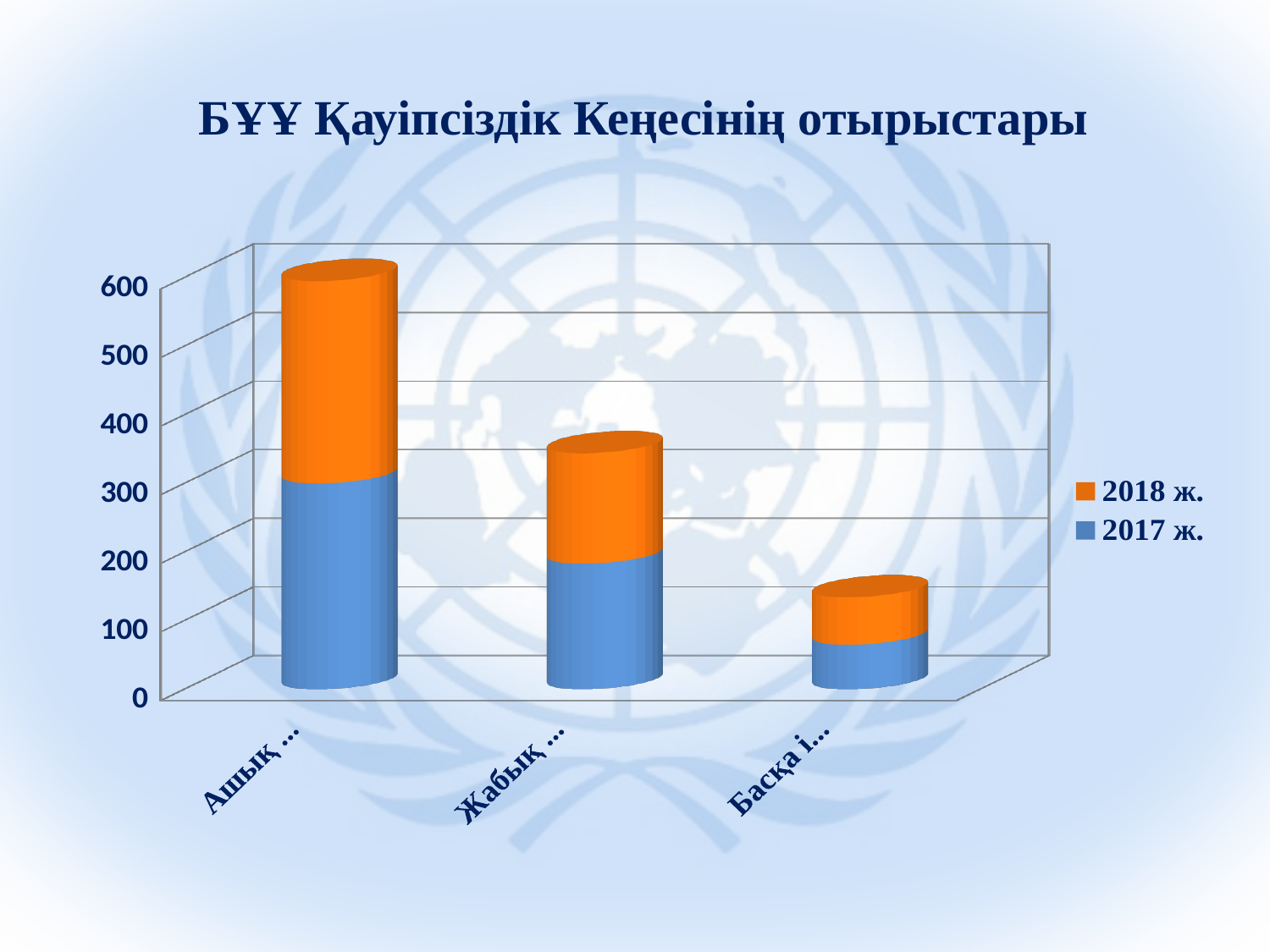
Which colour represents the 2018 ж. series in the legend? orange Which category has the shortest stacked bar? the third bar (Басқа і...) In the second bar (Жабық ...), which series has the larger value, 2017 ж. or 2018 ж.? 2017 ж. How many series does the legend list? 2 Is the total height of the second bar (Жабық ...) greater or less than 400? less Is the 2017 ж. portion of the first bar (Ашық ...) greater or less than 200? greater Is the total height of the first bar (Ашық ...) greater or less than 500? greater How many categories are plotted along the x axis? 3 What kind of chart is shown on the slide? bar chart Do the stacked bar totals rise or fall from left to right along the x axis? fall Which category has the tallest stacked bar? the first bar (Ашық ...)